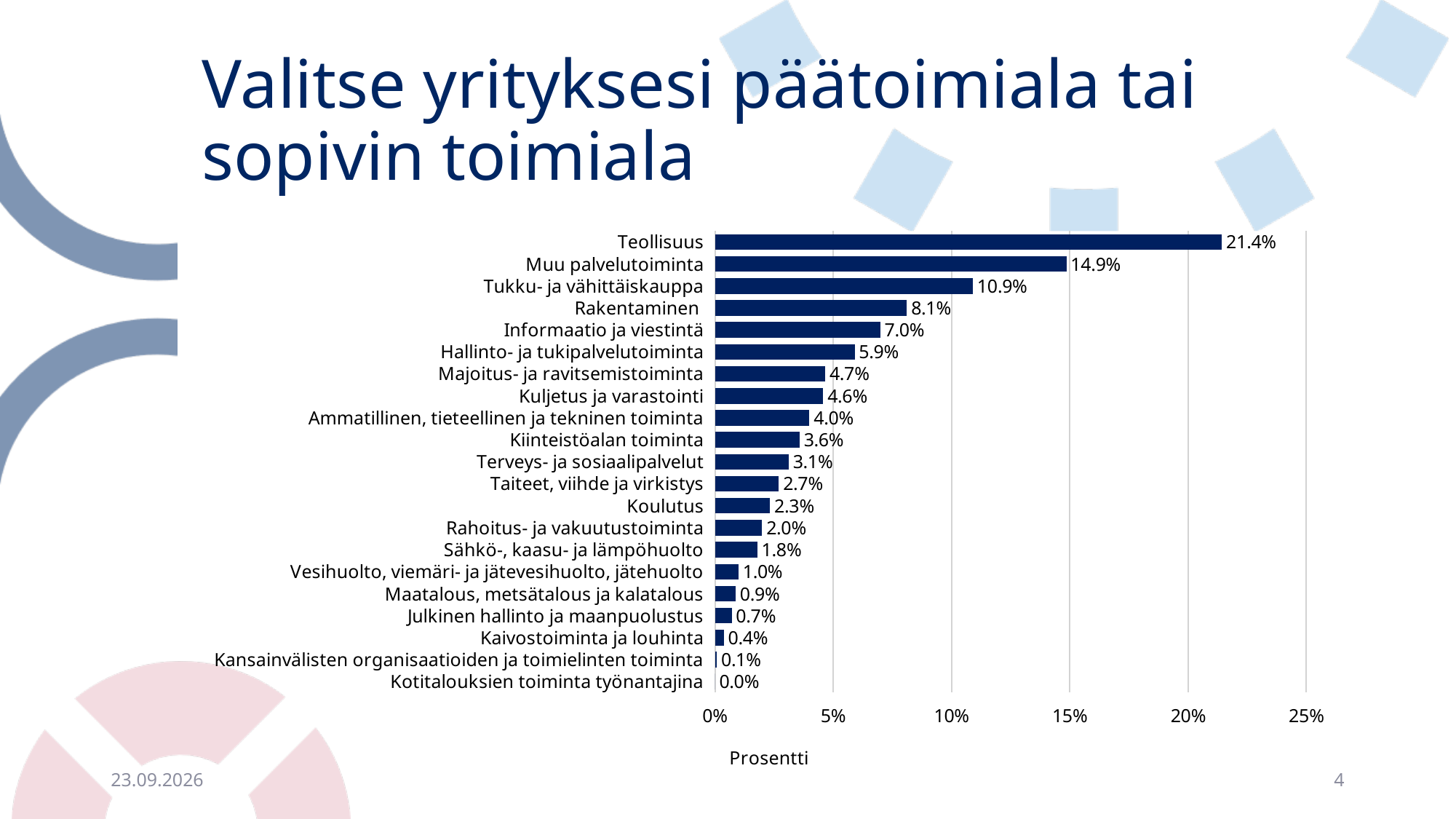
What is the label of the horizontal axis? Prosentti What kind of chart is shown on the slide? bar chart What is the difference between Tukku- ja vähittäiskauppa and Rakentaminen? 2.8% Which category has the highest value? Teollisuus Is the value for Tukku- ja vähittäiskauppa greater or less than 10%? greater How many categories are shown in the chart? 21 What is the difference between Teollisuus and Muu palvelutoiminta? 6.5% Which category has the lowest value? Kotitalouksien toiminta työnantajina What is the value for Rakentaminen? 8.1% What is the value for Teollisuus? 21.4% Which is larger, Informaatio ja viestintä or Hallinto- ja tukipalvelutoiminta? Informaatio ja viestintä What is the value for Koulutus? 2.3%